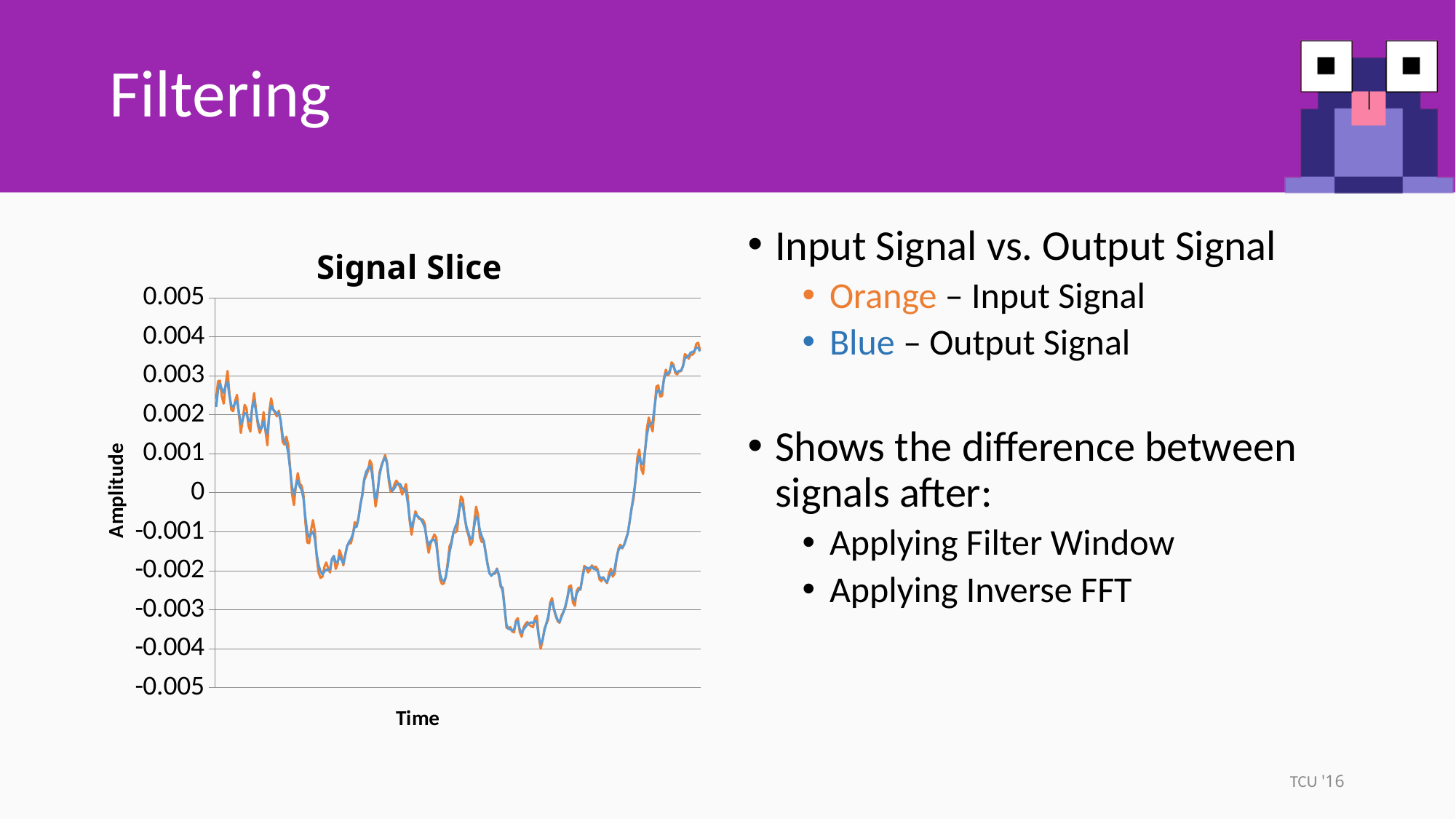
Does the signal rise or fall over the final portion of the time axis? rise What is the label of the vertical axis of the chart? Amplitude Is the signal value at the end of the time axis higher or lower than at the start? higher Is the value of the signal at the start of the time axis greater or less than 0.002? greater What is the highest value shown on the vertical axis of the chart? 0.005 What is the lowest value shown on the vertical axis of the chart? -0.005 What kind of chart is shown on the slide? line chart How many tick labels are shown on the vertical axis of the chart? 11 How many lines (series) are plotted in the Signal Slice chart? 2 Is the highest point of the signal in the chart greater or less than 0.003? greater Is the lowest point of the signal in the chart greater or less than -0.003? less What is the title of the chart? Signal Slice